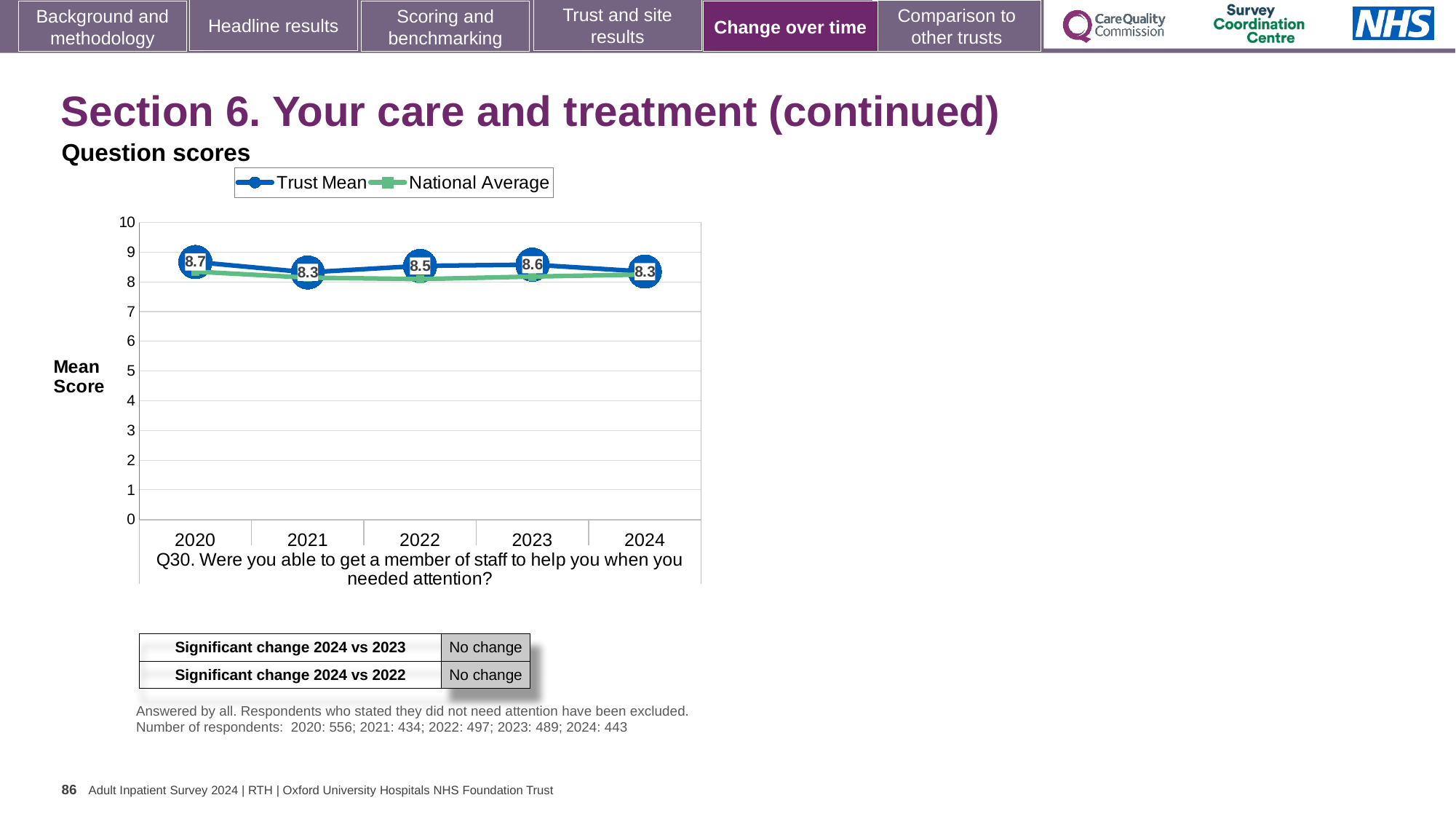
What is the difference between the Trust Mean score in 2020 and in 2024? 0.4 What is the Trust Mean score for 2022? 8.5 Is the National Average value for 2024 greater or less than 5? greater How many series does the chart legend list? 2 What kind of chart is shown on the slide? Line chart Is the National Average value for 2021 greater or less than 9? less Which is larger, the Trust Mean score for 2023 or for 2021? 2023 How many years are shown on the x axis of the chart? 5 What is the Trust Mean score for 2020? 8.7 Does the Trust Mean score rise or fall from 2023 to 2024? Fall What is the Trust Mean score for 2024? 8.3 In which year is the Trust Mean score highest? 2020